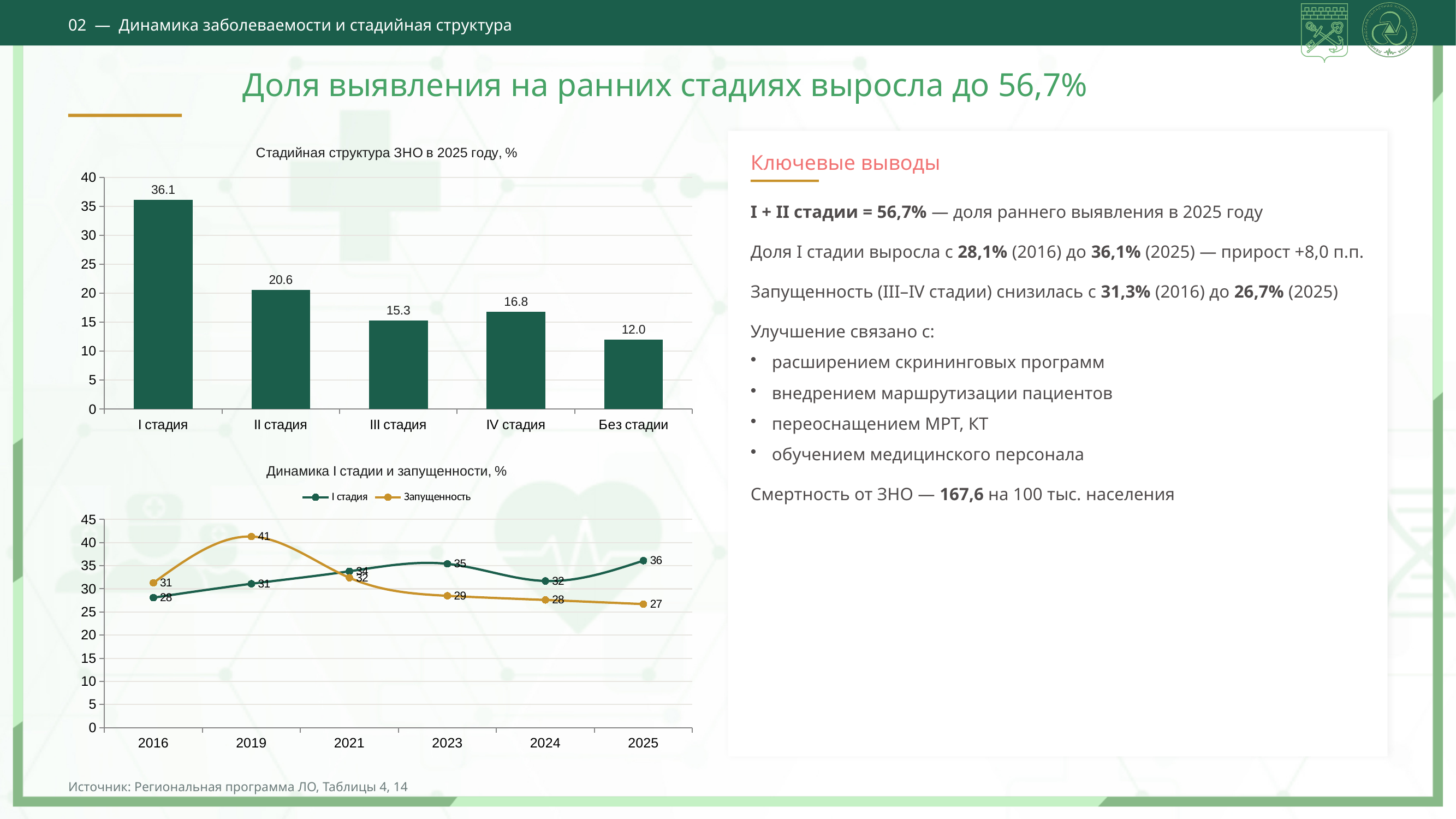
In the chart 'Стадийная структура ЗНО в 2025 году, %', what is the value for I стадия? 36.1 What type of chart is 'Стадийная структура ЗНО в 2025 году, %'? Bar chart In the chart 'Стадийная структура ЗНО в 2025 году, %', which is larger: III стадия or IV стадия? IV стадия In the chart 'Динамика I стадии и запущенности, %', what is the value of I стадия in 2025? 36 In the chart 'Стадийная структура ЗНО в 2025 году, %', what is the difference between I стадия and II стадия? 15.5 In the chart 'Динамика I стадии и запущенности, %', what is the difference between I стадия and Запущенность in 2025? 9 In the chart 'Динамика I стадии и запущенности, %', does Запущенность rise or fall from 2019 to 2025? Fall In the chart 'Стадийная структура ЗНО в 2025 году, %', which category has the lowest value? Без стадии In the chart 'Стадийная структура ЗНО в 2025 году, %', which category has the highest value? I стадия How many series does the legend list in the chart 'Динамика I стадии и запущенности, %'? 2 How many categories are shown in the chart 'Стадийная структура ЗНО в 2025 году, %'? 5 In the chart 'Динамика I стадии и запущенности, %', what is the value of Запущенность in 2019? 41